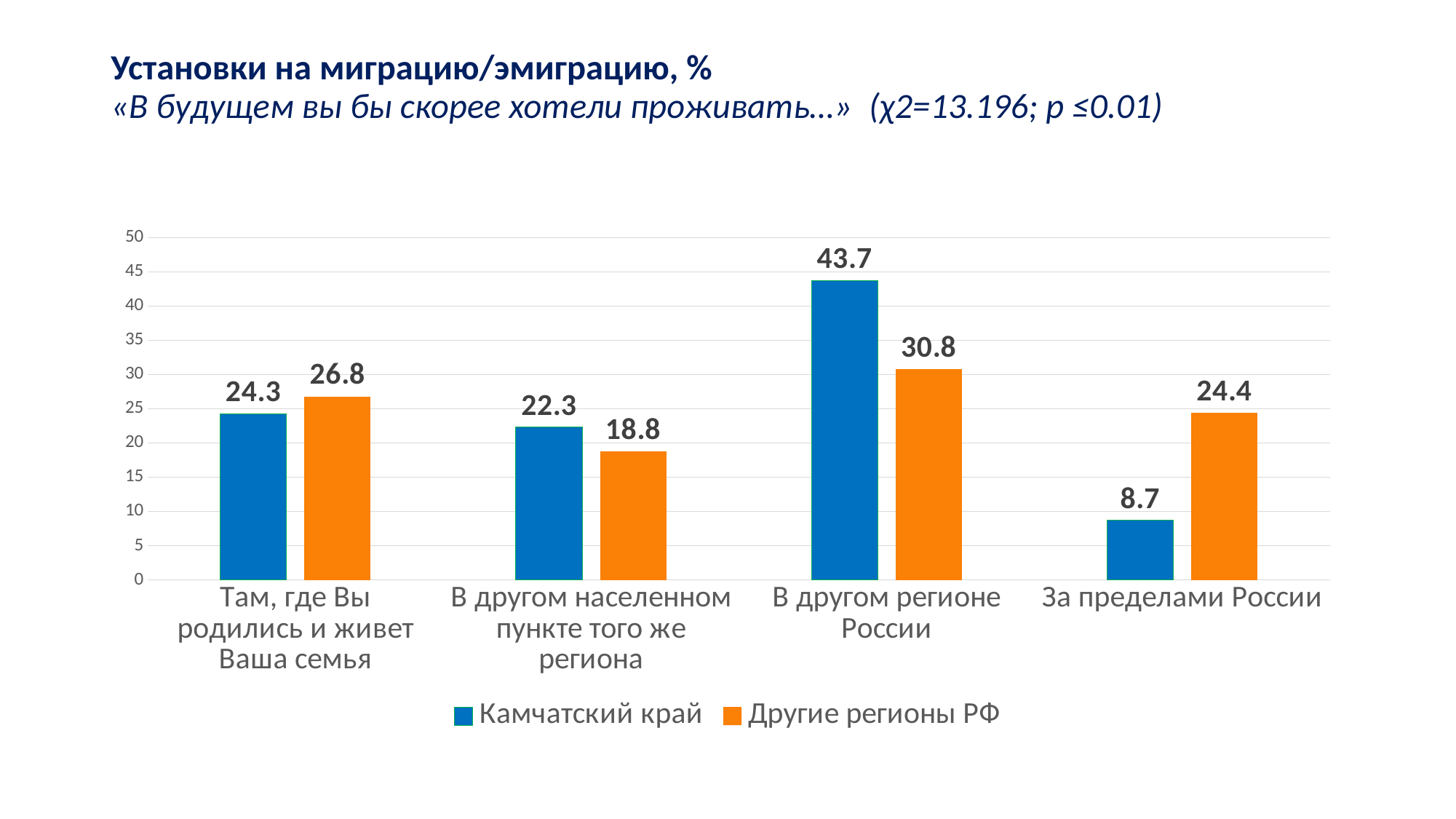
What is the difference between Камчатский край and Другие регионы РФ in the category «В другом регионе России»? 12.9 What is the value for Другие регионы РФ in the category «В другом населенном пункте того же региона»? 18.8 What is the value for Камчатский край in the category «Там, где Вы родились и живет Ваша семья»? 24.3 How many series does the legend list? 2 In the category «За пределами России», which series has the larger value: Камчатский край or Другие регионы РФ? Другие регионы РФ What kind of chart is shown on the slide? Bar chart How many categories are shown on the x axis? 4 What is the value for Другие регионы РФ in the category «За пределами России»? 24.4 Which category has the lowest value for Камчатский край? За пределами России Which category has the lowest value for Другие регионы РФ? В другом населенном пункте того же региона Which category has the highest value for Камчатский край? В другом регионе России What is the value for Камчатский край in the category «В другом регионе России»? 43.7